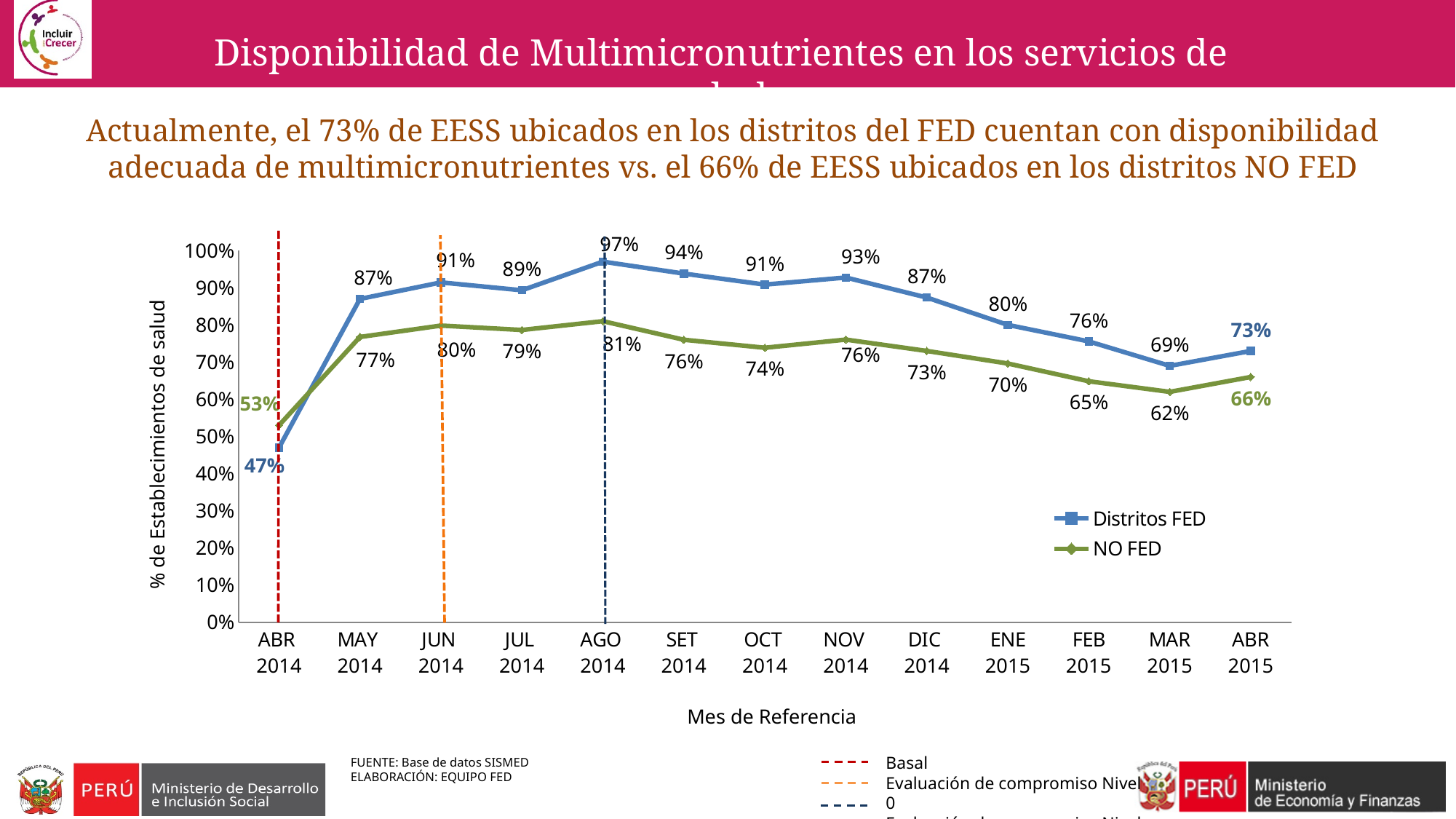
How many series does the legend list? 2 In which month does the NO FED series have its lowest value? ABR 2014 What is the value for Distritos FED in ABR 2014? 47% What is the difference between Distritos FED and NO FED in ABR 2015? 7% What is the value for Distritos FED in AGO 2014? 97% What is the label of the y axis? % de Establecimientos de salud What is the value for NO FED in MAR 2015? 62% How many months are plotted along the x axis? 13 What type of chart is shown on the slide? line chart Does the Distritos FED series rise or fall from NOV 2014 to MAR 2015? fall In which month does the Distritos FED series reach its highest value? AGO 2014 Which series has the higher value in ABR 2014, Distritos FED or NO FED? NO FED